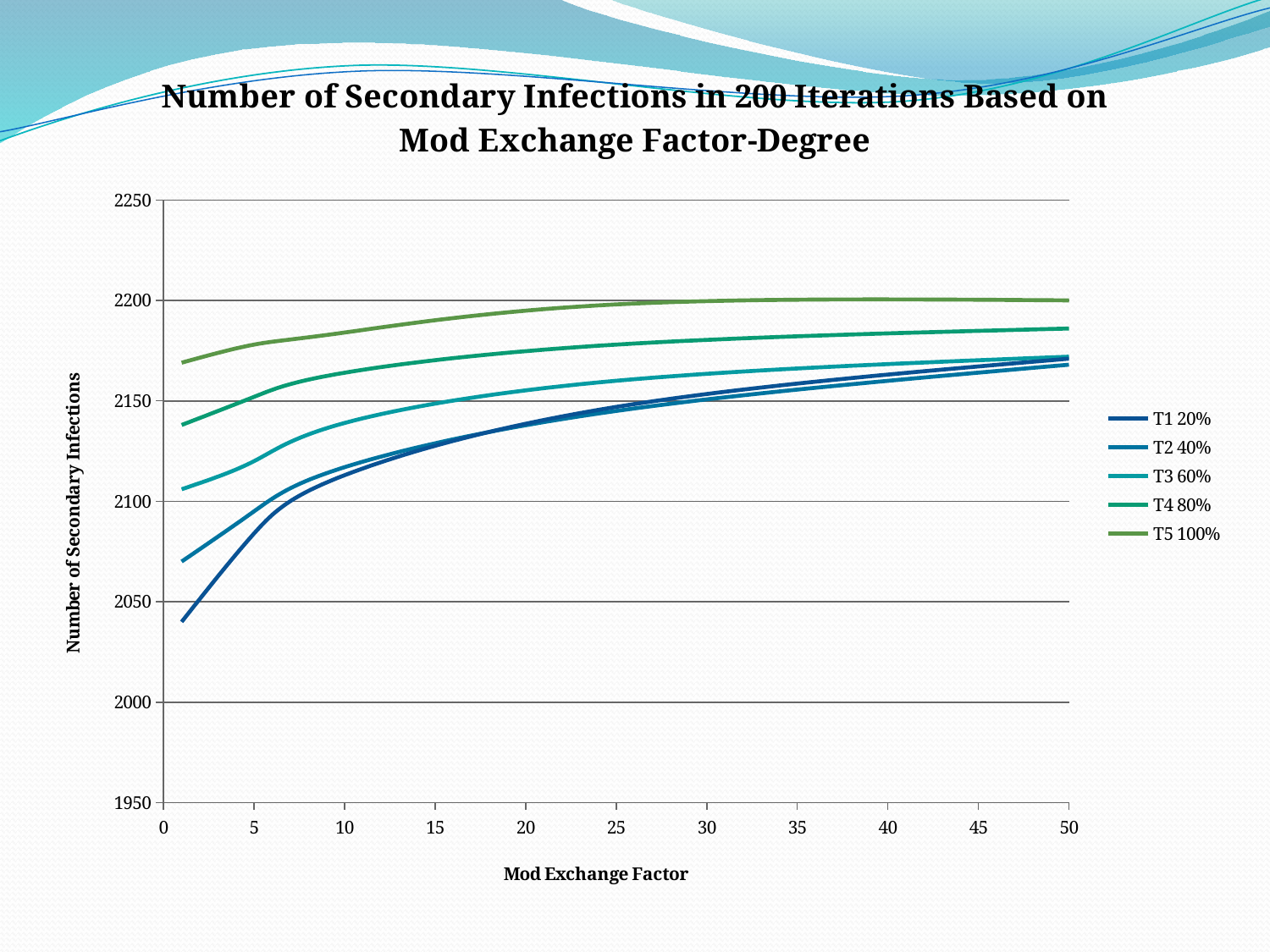
How many series does the legend list? 5 Is the value for T5 100% at a Mod Exchange Factor of 1 greater or less than 2150? greater Is the value for T4 80% at a Mod Exchange Factor of 50 greater or less than 2200? less Is the value for T2 40% at a Mod Exchange Factor of 1 greater or less than 2100? less Which series has the lowest number of secondary infections at a Mod Exchange Factor of 1? T1 20% At a Mod Exchange Factor of 1, which is larger: the value for T5 100% or the value for T1 20%? T5 100% Do the values for T1 20% rise or fall as the Mod Exchange Factor increases? rise Which series has the highest number of secondary infections across the whole range of Mod Exchange Factor? T5 100% What is the label of the x axis? Mod Exchange Factor What kind of chart is shown on the slide? line chart